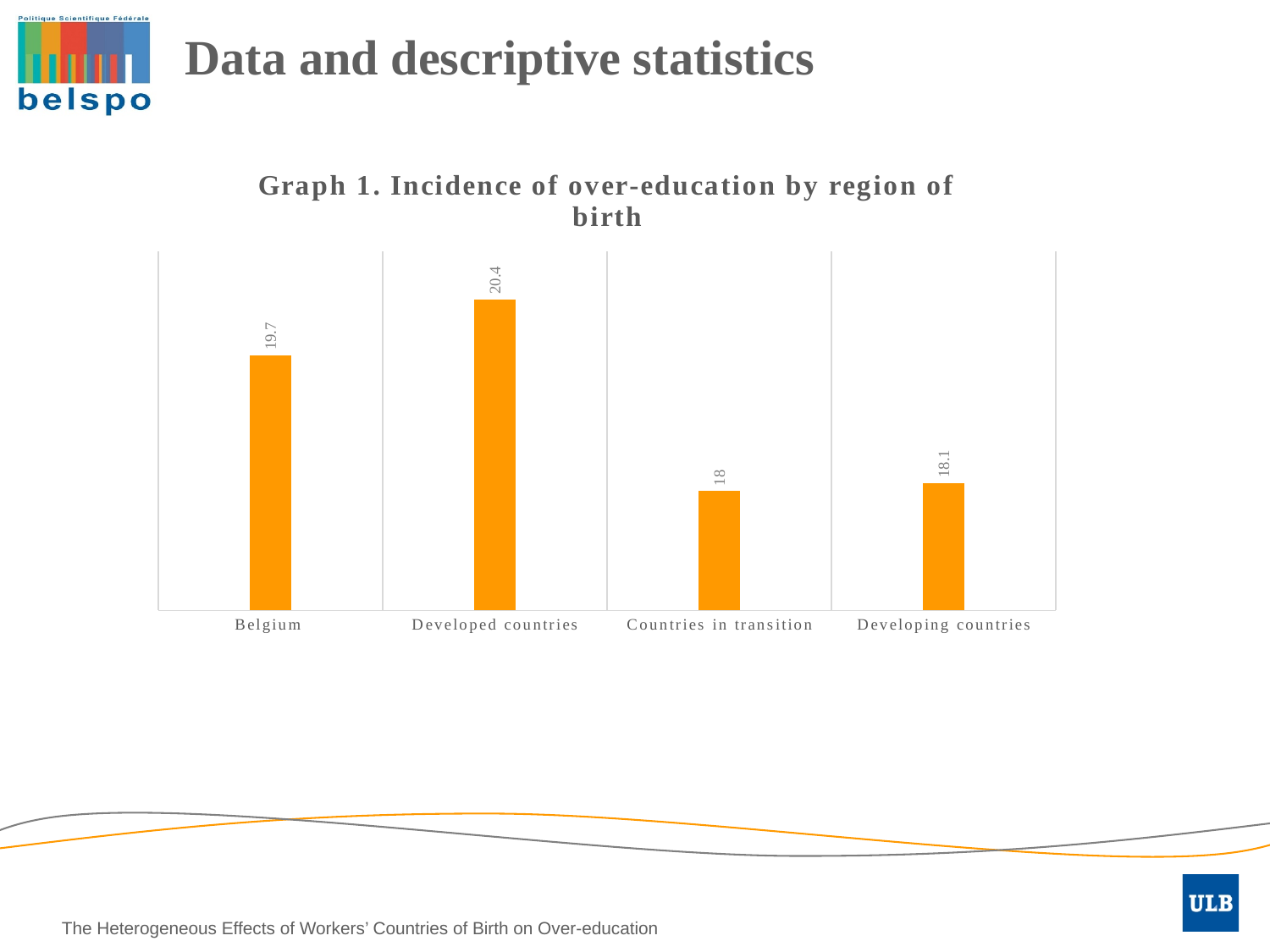
What is the value for Developing countries? 18.1 What kind of chart is shown on the slide? Bar chart What is the difference between the values for Belgium and Countries in transition? 1.7 What is the difference between the values for Developed countries and Belgium? 0.7 What is the value for Developed countries? 20.4 What is the title of the chart? Graph 1. Incidence of over-education by region of birth Which region of birth has the highest incidence of over-education? Developed countries What is the value for Belgium? 19.7 Which region of birth has the lowest incidence of over-education? Countries in transition What is the value for Countries in transition? 18 Which is larger, the value for Belgium or the value for Developing countries? Belgium How many categories are shown in the chart? 4